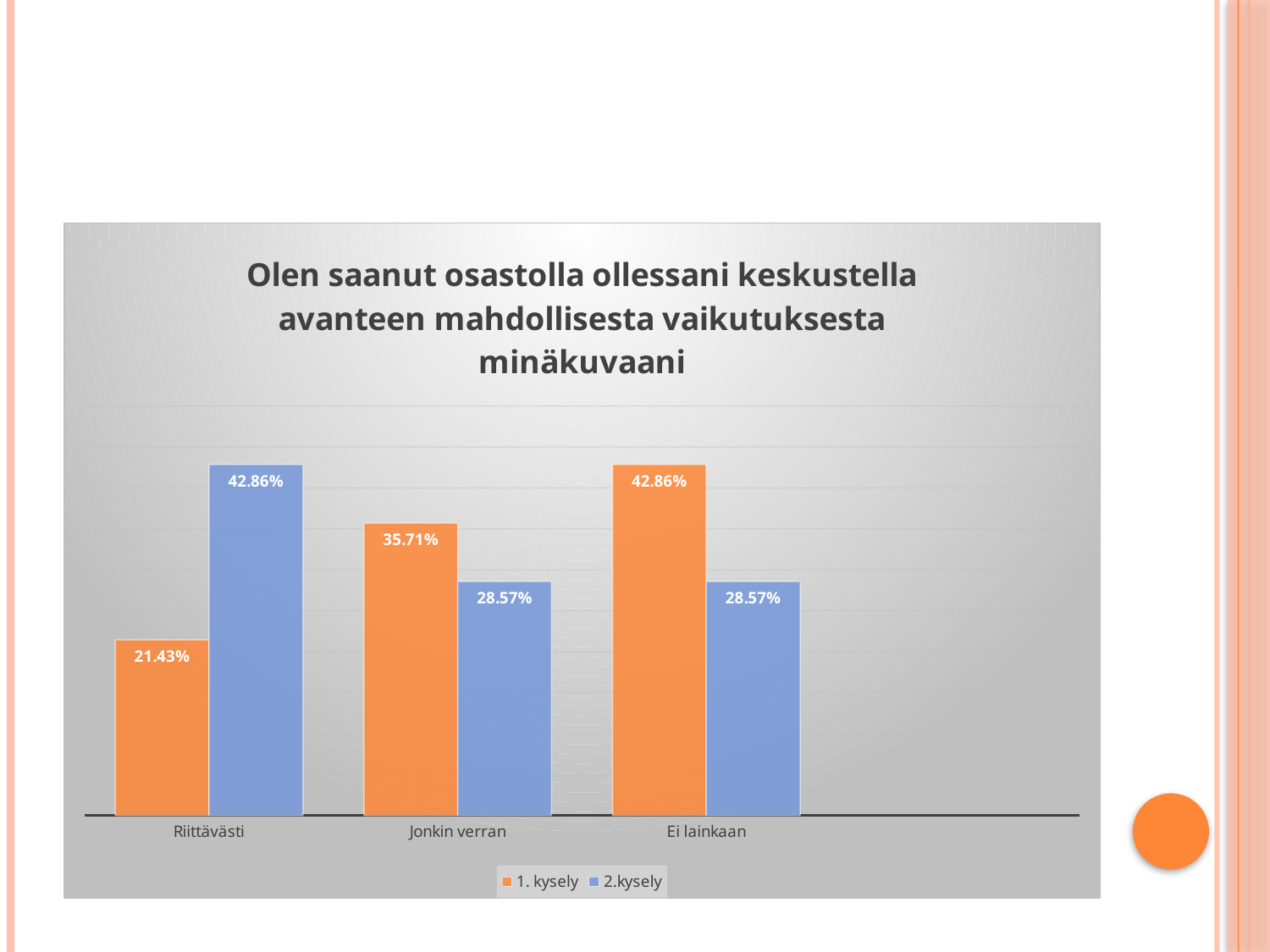
What is the value for Riittävästi in the 2.kysely series? 42.86% Which category has the lowest value in the 1. kysely series? Riittävästi What is the value for Ei lainkaan in the 2.kysely series? 28.57% How many categories are shown on the x axis? 3 What is the value for Jonkin verran in the 1. kysely series? 35.71% Which category has the highest value in the 1. kysely series? Ei lainkaan For Jonkin verran, which series has the larger value, 1. kysely or 2.kysely? 1. kysely What is the difference between the 1. kysely and 2.kysely values for Ei lainkaan? 14.29 percentage points What is the difference between the 2.kysely and 1. kysely values for Riittävästi? 21.43 percentage points Which category has the highest value in the 2.kysely series? Riittävästi What is the value for Riittävästi in the 1. kysely series? 21.43% How many series does the legend list? 2